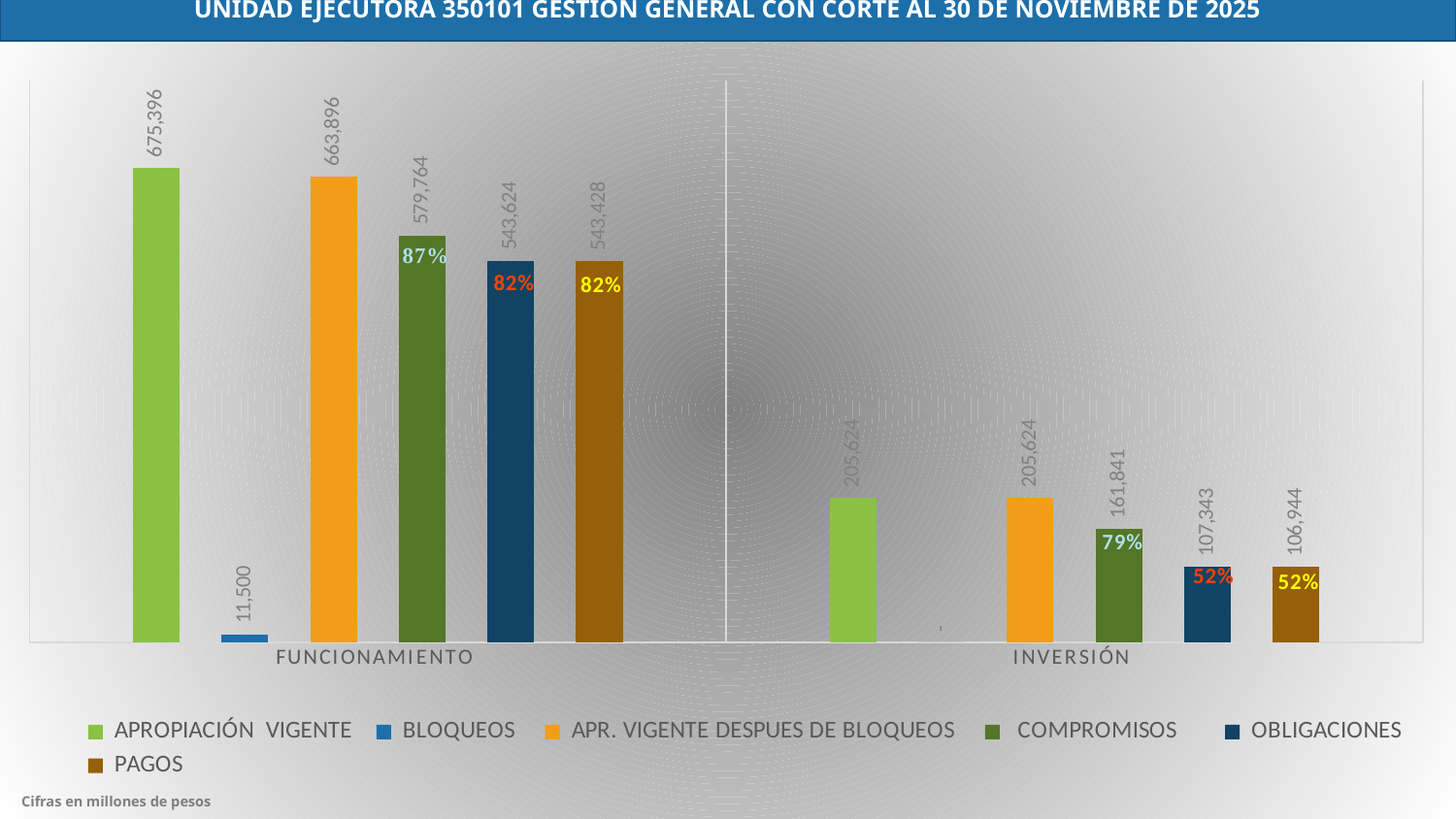
Which series has the highest value for FUNCIONAMIENTO? APROPIACIÓN VIGENTE Which is larger: COMPROMISOS for FUNCIONAMIENTO or COMPROMISOS for INVERSIÓN? COMPROMISOS for FUNCIONAMIENTO How many series does the legend list? 6 What is the difference between APROPIACIÓN VIGENTE and APR. VIGENTE DESPUES DE BLOQUEOS for FUNCIONAMIENTO? 11,500 What percentage is shown on the COMPROMISOS bar for INVERSIÓN? 79% What is the value of COMPROMISOS for INVERSIÓN? 161,841 What kind of chart is shown on the slide? Bar chart What is the value of APROPIACIÓN VIGENTE for FUNCIONAMIENTO? 675,396 What is the value of BLOQUEOS for FUNCIONAMIENTO? 11,500 What percentage is shown on the OBLIGACIONES bar for FUNCIONAMIENTO? 82% What is the value of PAGOS for INVERSIÓN? 106,944 What is the difference between APROPIACIÓN VIGENTE and COMPROMISOS for INVERSIÓN? 43,783